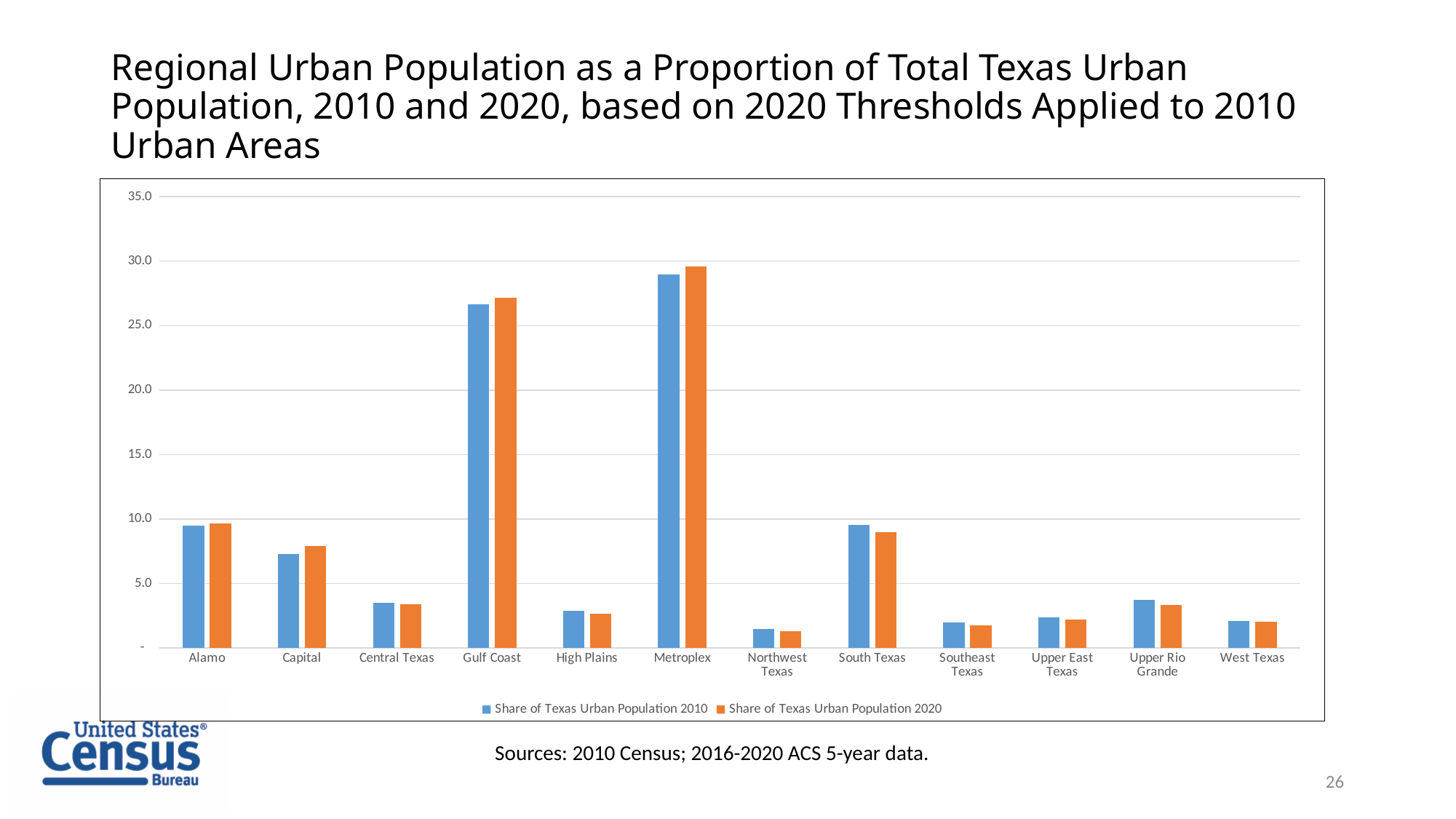
What colour are the bars for Share of Texas Urban Population 2020? orange For Capital, which is larger: the Share of Texas Urban Population 2010 or the Share of Texas Urban Population 2020? Share of Texas Urban Population 2020 How many regions are shown on the x axis of the chart? 12 Is the Share of Texas Urban Population 2020 for Gulf Coast greater or less than 25.0? greater What kind of chart is shown on the slide? bar chart Is the Share of Texas Urban Population 2010 for Metroplex greater or less than 30.0? less Which region has the highest Share of Texas Urban Population 2020? Metroplex Which region has the lowest Share of Texas Urban Population 2010? Northwest Texas Which is larger for 2010: the share for Gulf Coast or the share for Metroplex? Metroplex Is the Share of Texas Urban Population 2010 for Alamo greater or less than 10.0? less How many series does the chart's legend list? 2